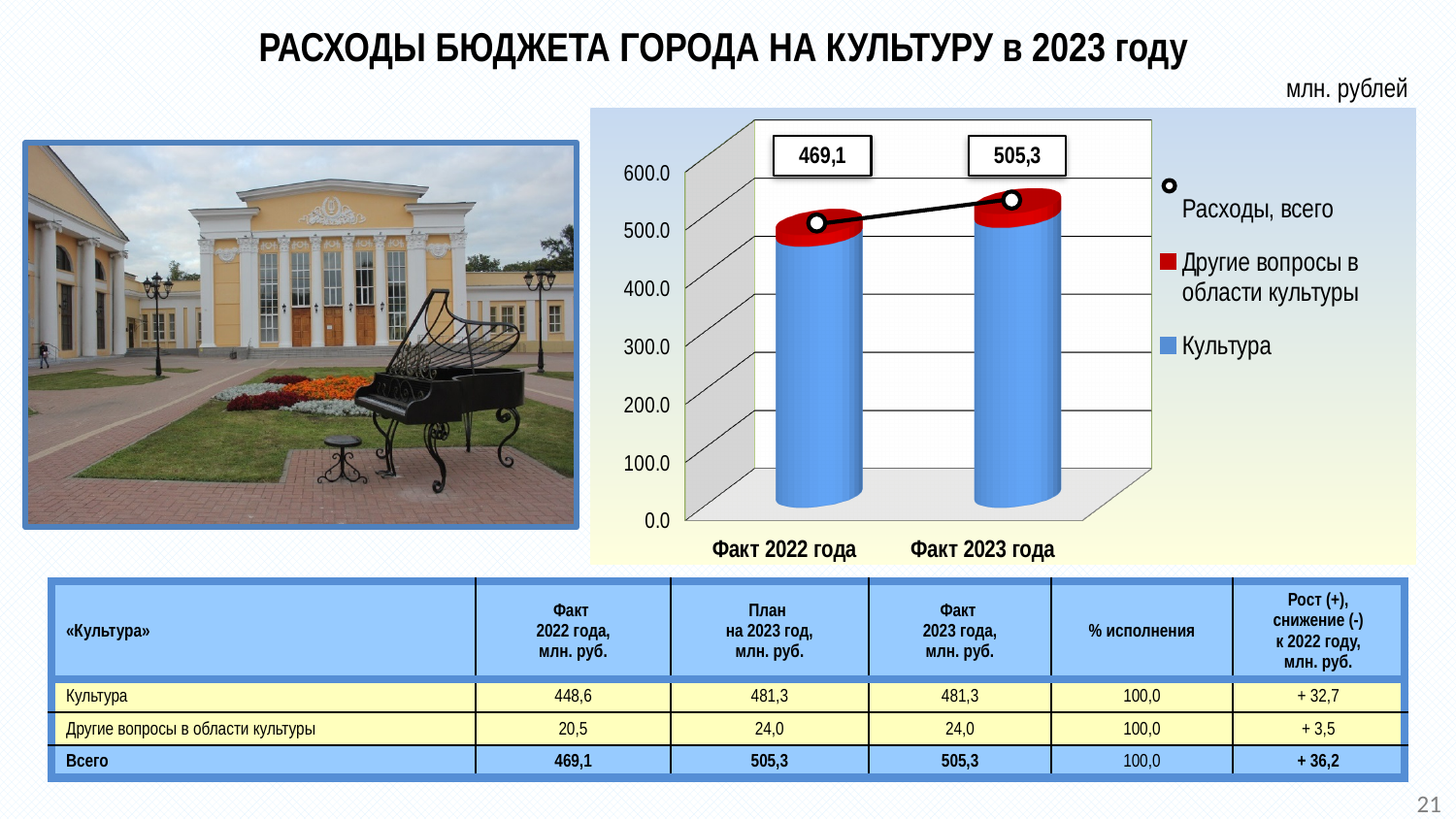
Which series is shown in red in the chart legend? Другие вопросы в области культуры What is the value of the 'Расходы, всего' series for 'Факт 2022 года'? 469,1 What is the value of the 'Расходы, всего' series for 'Факт 2023 года'? 505,3 What kind of chart is shown on the slide? Stacked bar chart with a line How many series does the chart legend list? 3 How many categories are shown on the x axis of the chart? 2 Is the 'Расходы, всего' value for 'Факт 2022 года' larger or smaller than the value for 'Факт 2023 года'? smaller Which category has the higher 'Расходы, всего' value, 'Факт 2022 года' or 'Факт 2023 года'? Факт 2023 года Is the total height of the stacked bar for 'Факт 2023 года' greater or less than 400.0? greater Is the 'Культура' segment of the 'Факт 2022 года' bar greater or less than 300.0? greater Does the 'Расходы, всего' line rise or fall from 'Факт 2022 года' to 'Факт 2023 года'? rise What is the difference between the 'Расходы, всего' values for 'Факт 2023 года' and 'Факт 2022 года'? 36,2